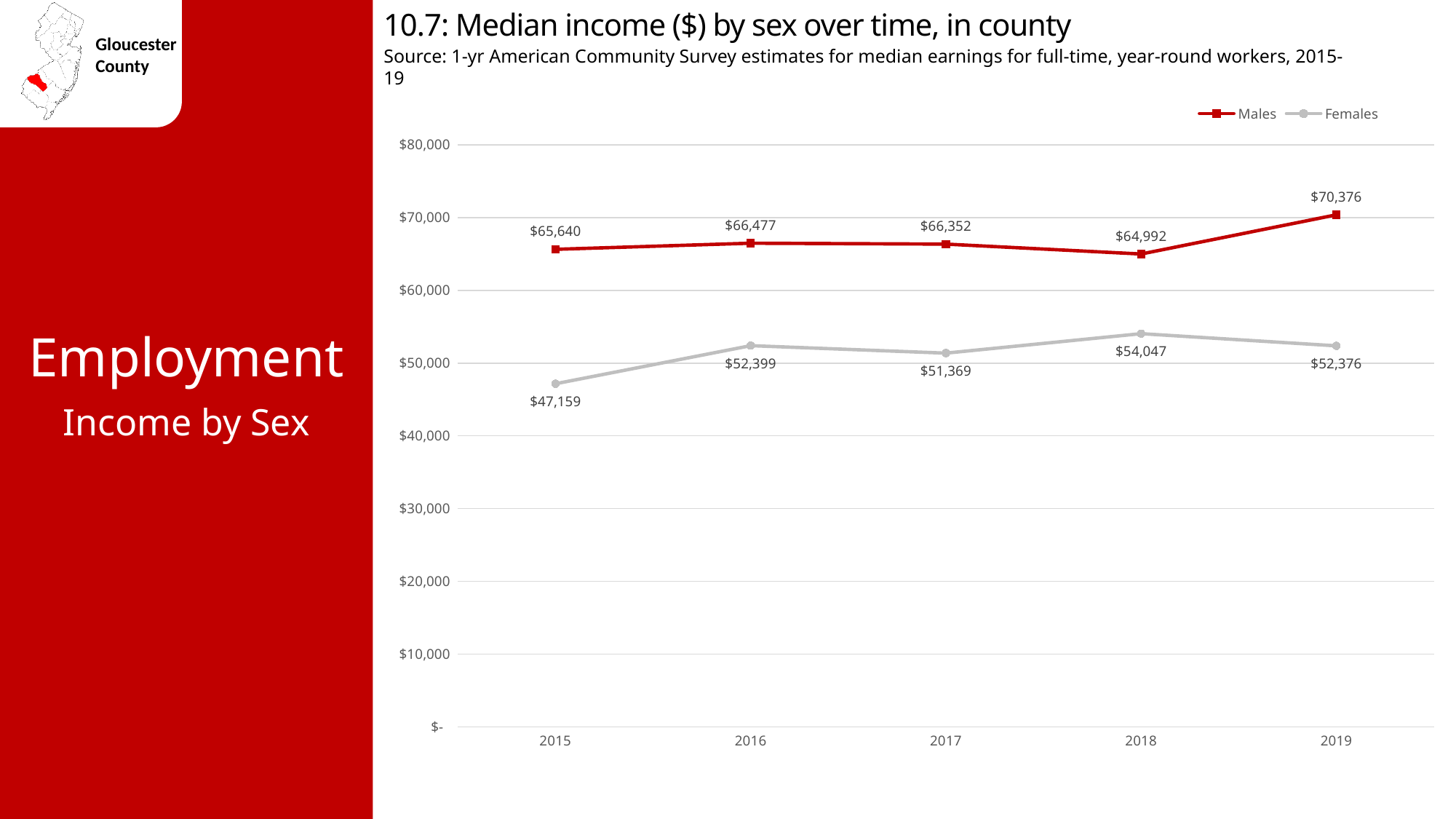
How many years are shown on the x axis? 5 In which year was the median income for Females the lowest? 2015 How many series does the legend list? 2 What was the median income for Females in 2018? $54,047 What is the difference between the Males and Females median income in 2019? $18,000 In which year was the median income for Males the highest? 2019 What kind of chart is shown on the slide? Line chart What was the median income for Males in 2019? $70,376 Did the median income for Males rise or fall from 2018 to 2019? Rise Which was larger in 2017, the median income for Males or for Females? Males What was the median income for Females in 2015? $47,159 Is the median income for Females in 2016 greater or less than $50,000? greater